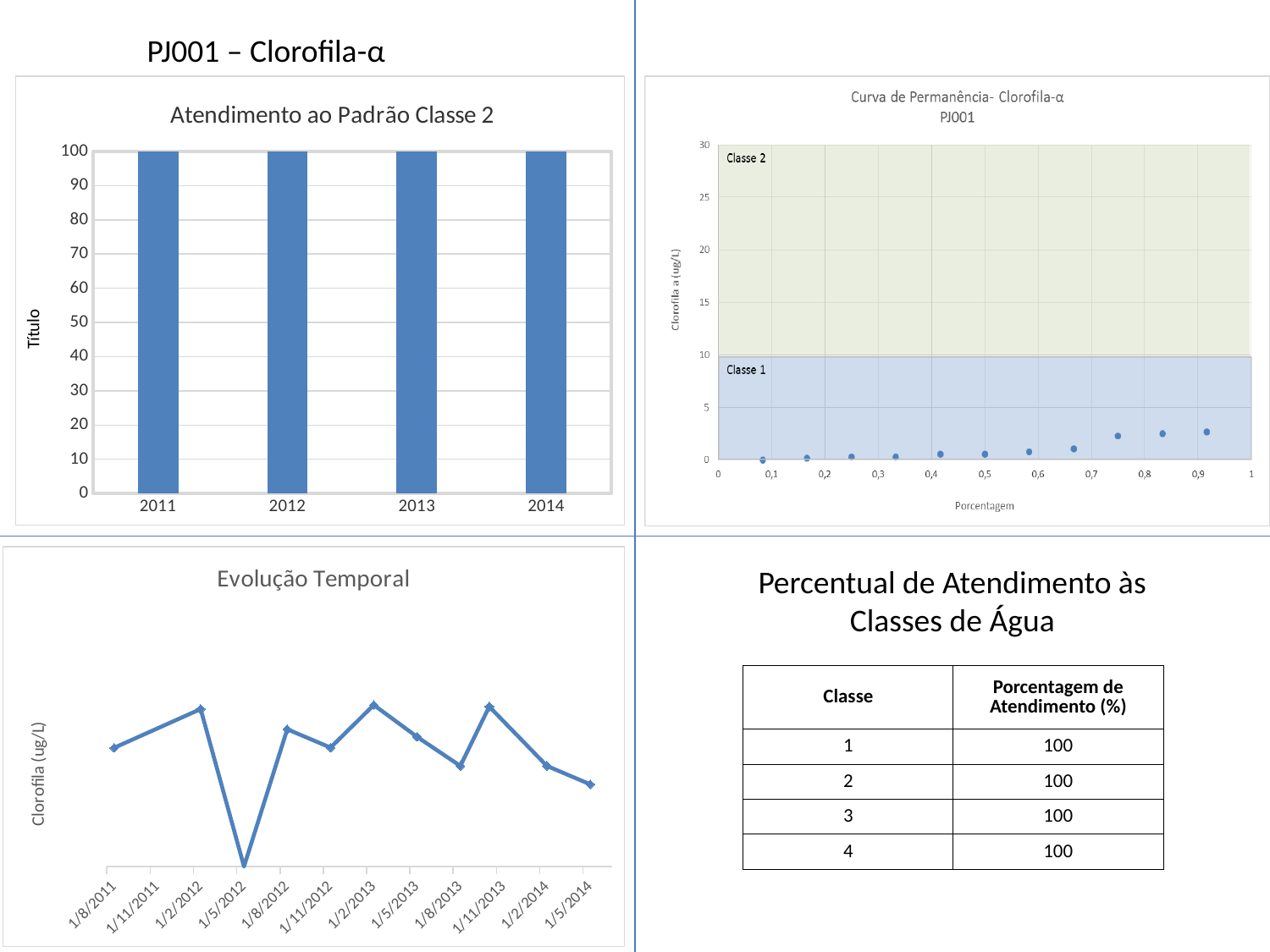
In the 'Evolução Temporal' chart, which is larger, the value for 1/2/2012 or the value for 1/5/2013? 1/2/2012 In the 'Curva de Permanência - Clorofila-α PJ001' chart, do the values rise or fall as Porcentagem increases? rise In the 'Atendimento ao Padrão Classe 2' chart, how many years are shown on the x axis? 4 In the 'Curva de Permanência - Clorofila-α PJ001' chart, is the value at Porcentagem 0,9 greater or less than 5? less In the 'Atendimento ao Padrão Classe 2' chart, what is the difference between the values for 2012 and 2013? 0 In the 'Atendimento ao Padrão Classe 2' chart, what is the value for 2011? 100 What kind of chart is 'Atendimento ao Padrão Classe 2'? bar chart In the 'Atendimento ao Padrão Classe 2' chart, what is the y-axis title? Título In the 'Evolução Temporal' chart, which date has the lowest value? 1/5/2012 In the 'Atendimento ao Padrão Classe 2' chart, what is the value for 2014? 100 What kind of chart is 'Evolução Temporal'? line chart In the 'Curva de Permanência - Clorofila-α PJ001' chart, which class region do all the plotted points fall in? Classe 1